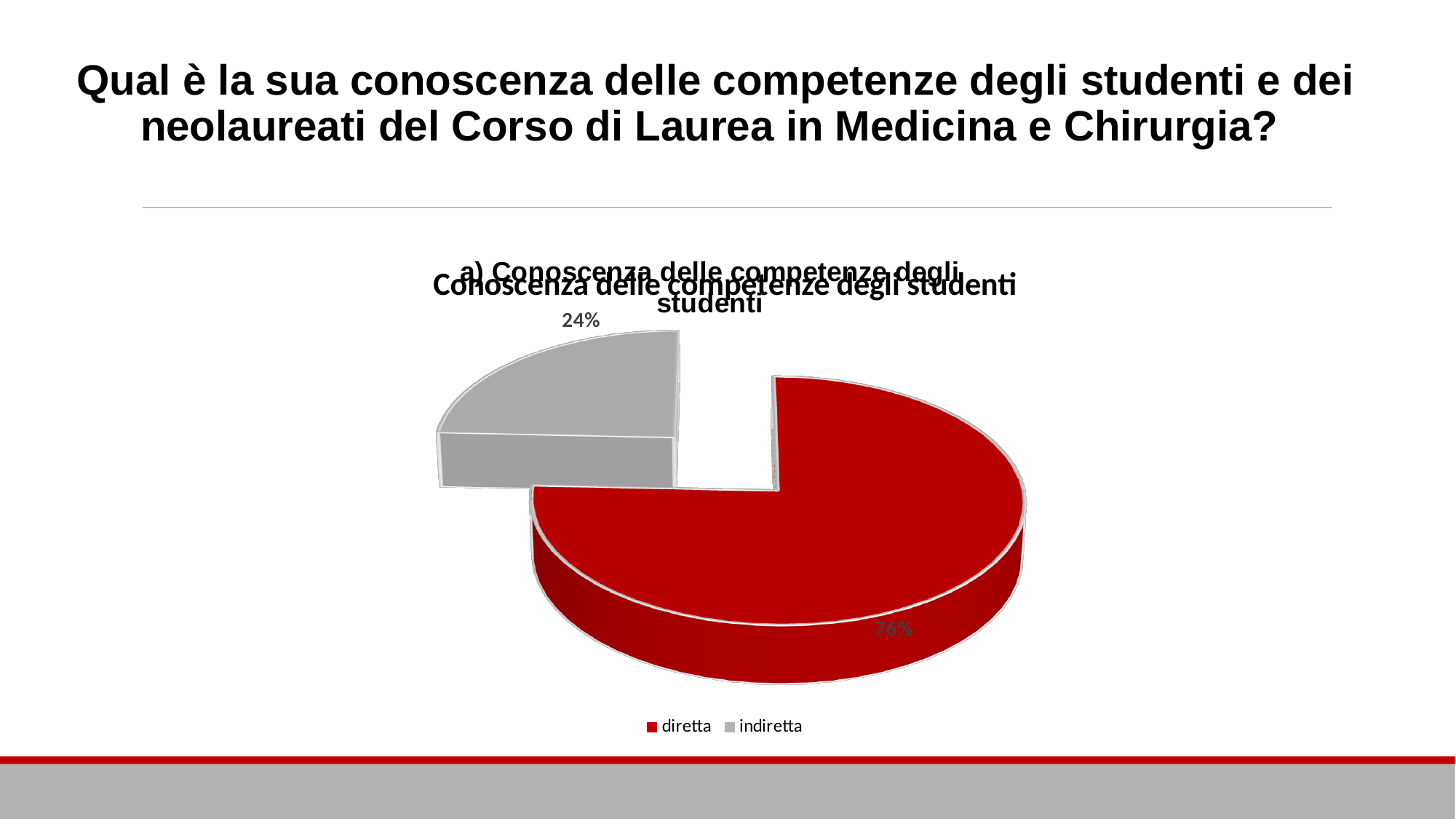
What percentage of the pie is labelled "indiretta"? 24% Which slice of the pie is the largest? diretta What kind of chart is shown on the slide? pie chart What is the difference in percentage points between the "diretta" and "indiretta" slices? 52 What percentage of the pie is labelled "diretta"? 76% What colour is the "indiretta" slice? grey How many slices does the pie chart have? 2 Which is larger, the "diretta" slice or the "indiretta" slice? diretta What colour is the "diretta" slice? red How many entries does the legend list? 2 Which slice of the pie is the smallest? indiretta